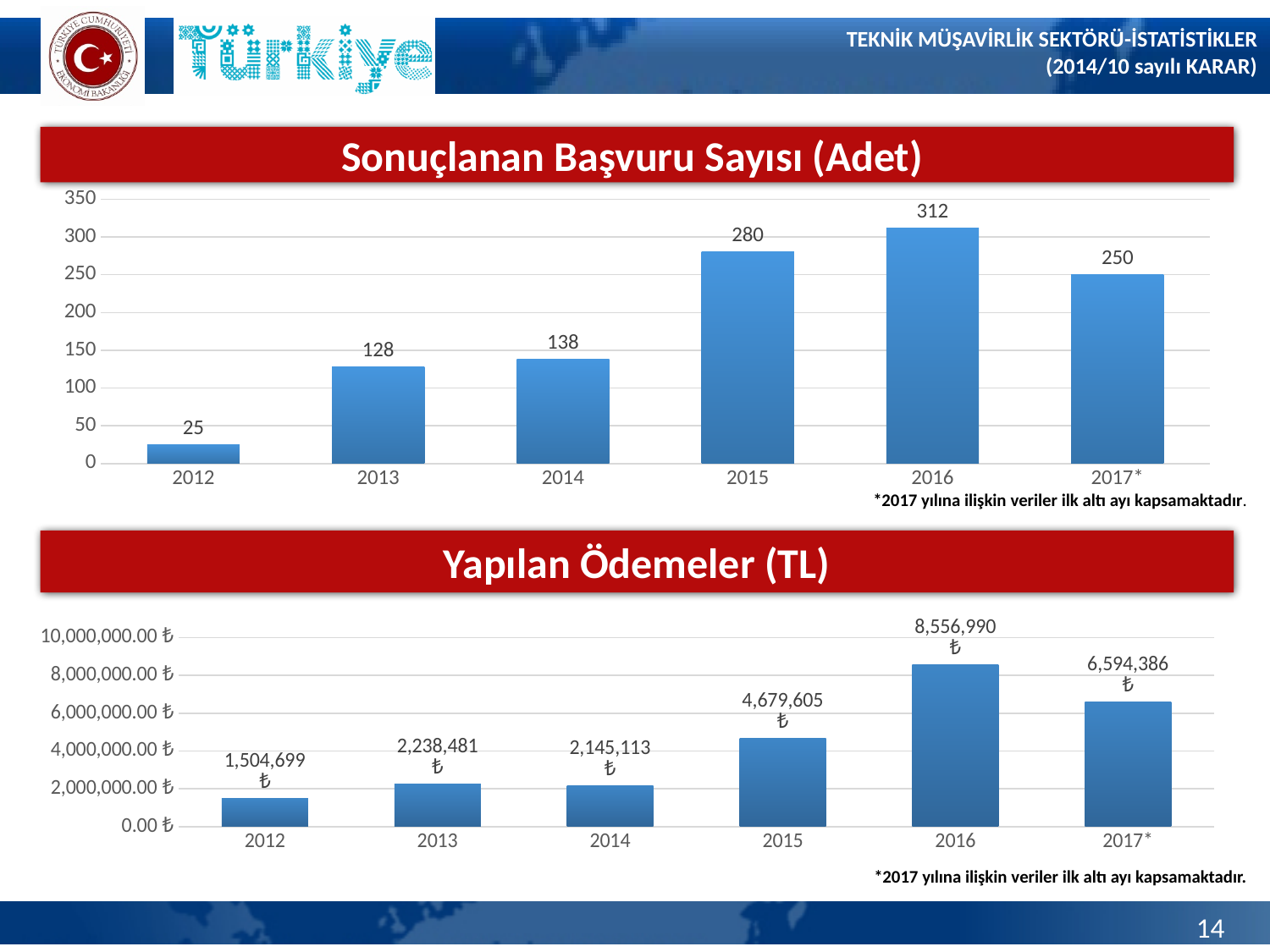
In the 'Sonuçlanan Başvuru Sayısı (Adet)' chart, how many years are shown on the x axis? 6 In the 'Yapılan Ödemeler (TL)' chart, what is the value for 2012? 1,504,699 ₺ In the 'Yapılan Ödemeler (TL)' chart, which is larger, the value for 2013 or the value for 2014? 2013 In the 'Sonuçlanan Başvuru Sayısı (Adet)' chart, do the values rise or fall from 2012 to 2016? Rise In the 'Sonuçlanan Başvuru Sayısı (Adet)' chart, what is the value for 2015? 280 In the 'Yapılan Ödemeler (TL)' chart, what is the value for 2016? 8,556,990 ₺ In the 'Sonuçlanan Başvuru Sayısı (Adet)' chart, which year has the lowest value? 2012 In the 'Yapılan Ödemeler (TL)' chart, what is the difference between the values for 2016 and 2015? 3,877,385 ₺ In the 'Sonuçlanan Başvuru Sayısı (Adet)' chart, what is the difference between the values for 2016 and 2017*? 62 In the 'Sonuçlanan Başvuru Sayısı (Adet)' chart, which year has the highest value? 2016 In the 'Yapılan Ödemeler (TL)' chart, is the value for 2015 greater or less than 4,000,000.00 ₺? greater What kind of chart is the 'Sonuçlanan Başvuru Sayısı (Adet)' chart? Bar chart